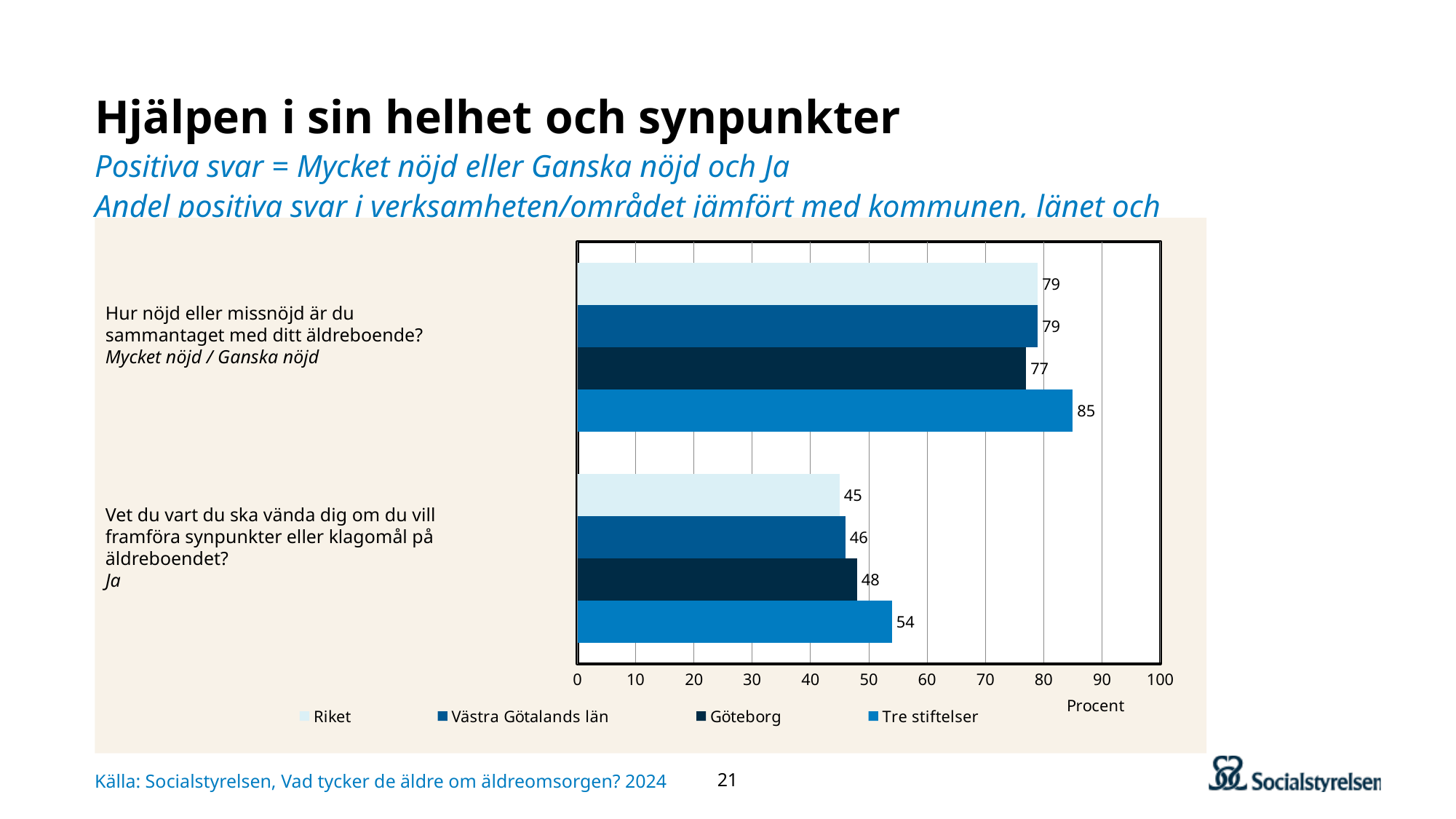
Which series has the highest value on the question "Vet du vart du ska vända dig om du vill framföra synpunkter eller klagomål på äldreboendet?"? Tre stiftelser What is the value for Västra Götalands län on the question "Hur nöjd eller missnöjd är du sammantaget med ditt äldreboende?"? 79 What is the value for Riket on the question "Vet du vart du ska vända dig om du vill framföra synpunkter eller klagomål på äldreboendet?"? 45 What is the value for Tre stiftelser on the question "Hur nöjd eller missnöjd är du sammantaget med ditt äldreboende?"? 85 What is the value for Göteborg on the question "Vet du vart du ska vända dig om du vill framföra synpunkter eller klagomål på äldreboendet?"? 48 What kind of chart is shown on the slide? Bar chart What is the difference between Tre stiftelser and Göteborg on the question "Hur nöjd eller missnöjd är du sammantaget med ditt äldreboende?"? 8 Which series has the lowest value on the question "Hur nöjd eller missnöjd är du sammantaget med ditt äldreboende?"? Göteborg How many series does the legend list? 4 What unit is shown on the horizontal axis of the chart? Procent Which is larger on the question "Vet du vart du ska vända dig om du vill framföra synpunkter eller klagomål på äldreboendet?": Göteborg or Västra Götalands län? Göteborg What is the difference between Tre stiftelser and Riket on the question "Vet du vart du ska vända dig om du vill framföra synpunkter eller klagomål på äldreboendet?"? 9